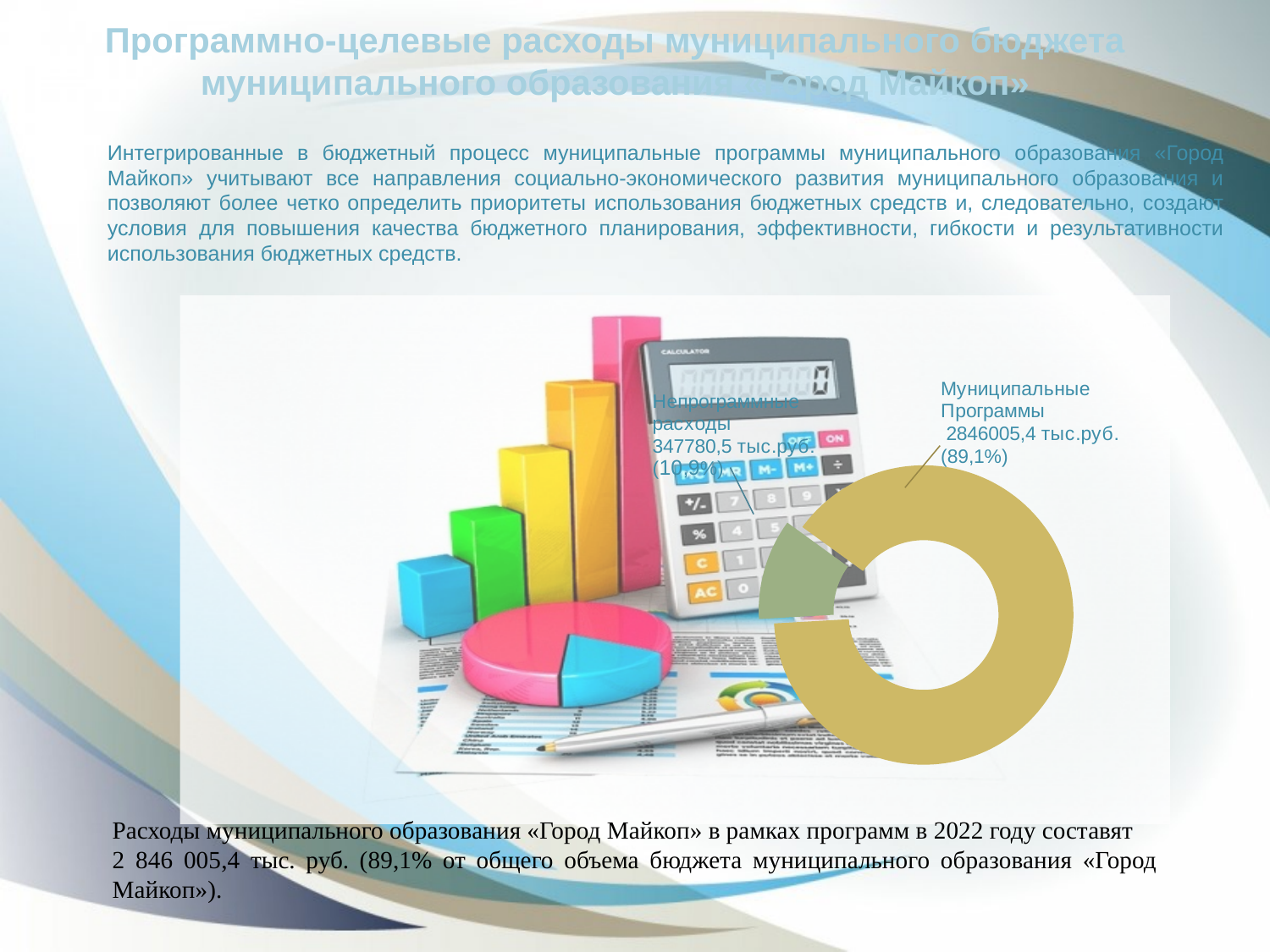
Which slice of the doughnut chart is the largest? Муниципальные Программы What colour is the Муниципальные Программы slice in the doughnut chart? Gold (yellow-brown) What is the value shown for Муниципальные Программы in the doughnut chart? 2846005,4 тыс.руб. Which slice of the doughnut chart is the smallest? Непрограммные расходы How many slices does the doughnut chart have? 2 What is the difference in тыс.руб. between Муниципальные Программы and Непрограммные расходы in the doughnut chart? 2498224,9 тыс.руб. By how many percentage points does the share of Муниципальные Программы exceed the share of Непрограммные расходы? 78,2 What share of the doughnut chart does Непрограммные расходы represent? 10,9% Which is larger in the doughnut chart: Муниципальные Программы or Непрограммные расходы? Муниципальные Программы What share of the doughnut chart does Муниципальные Программы represent? 89,1% What kind of chart is shown on the slide? Doughnut (pie) chart What is the value shown for Непрограммные расходы in the doughnut chart? 347780,5 тыс.руб.